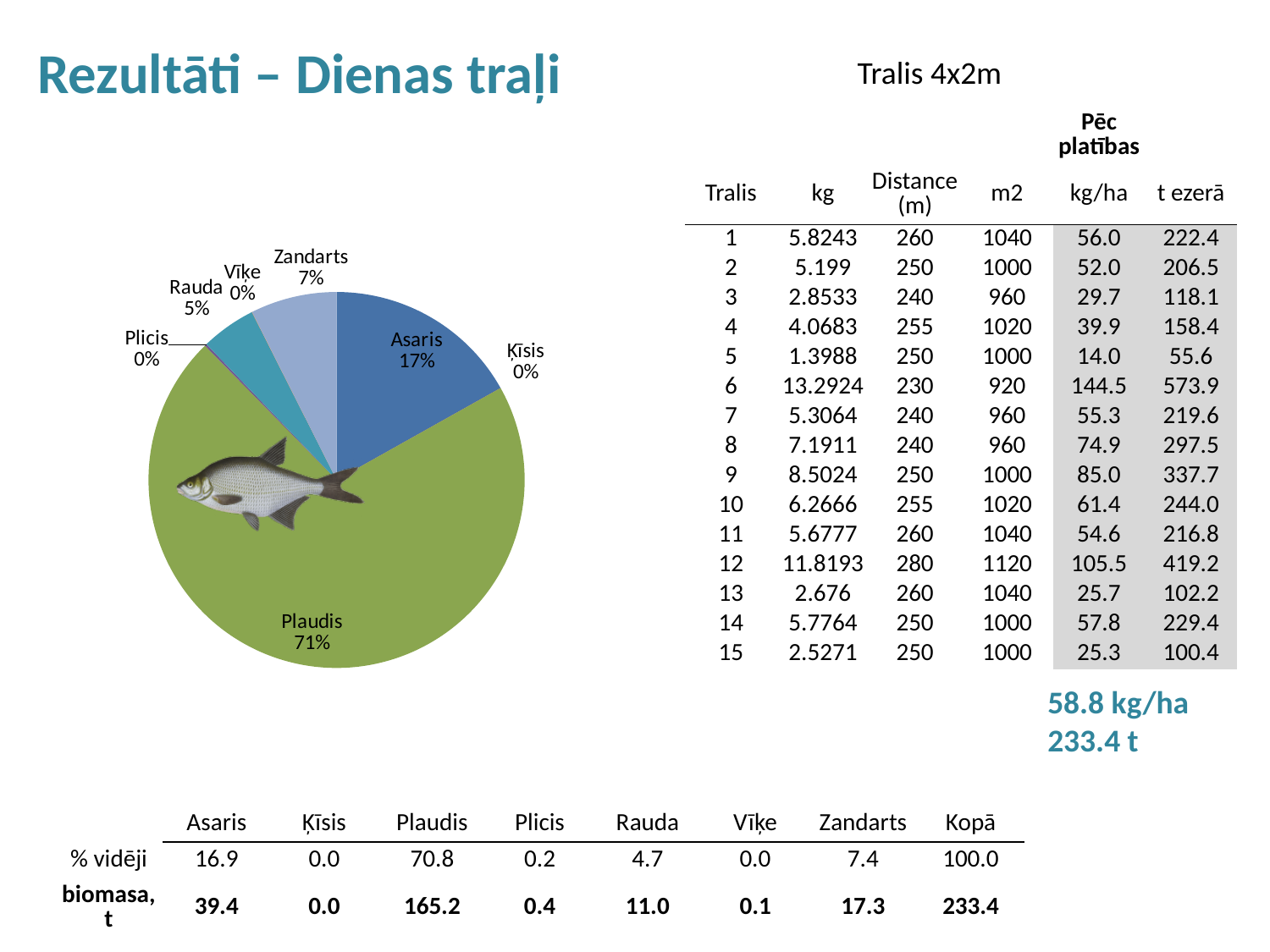
What share of the pie chart does Rauda have? 5% Which category has the largest slice in the pie chart? Plaudis What share of the pie chart does Plaudis have? 71% Which slice is larger in the pie chart, Asaris or Zandarts? Asaris Which slice is larger in the pie chart, Zandarts or Rauda? Zandarts What percentage is shown for Vīķe in the pie chart? 0% What kind of chart is shown on the slide? pie chart What share of the pie chart does Zandarts have? 7% How many categories are labelled in the pie chart? 7 What is the combined share of Asaris and Zandarts in the pie chart? 24% What is the difference in percentage points between the Plaudis and Asaris slices in the pie chart? 54 What share of the pie chart does Asaris have? 17%